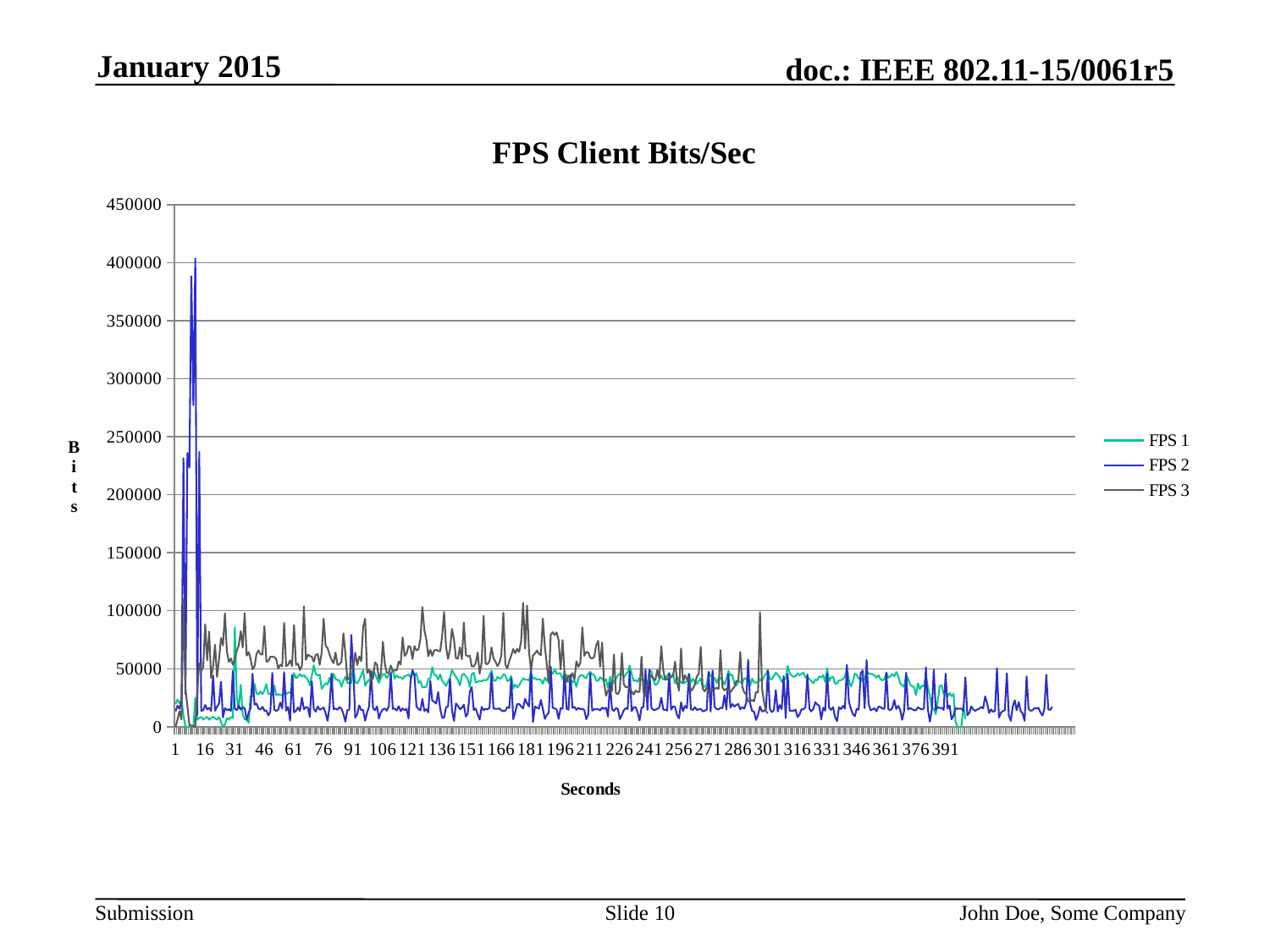
What is the title of the chart? FPS Client Bits/Sec How many series does the legend list? 3 Which series has the lowest peak value? FPS 1 Do the values of FPS 3 generally rise or fall from the start to the end of the x axis? fall What is the label of the x axis? Seconds What kind of chart is shown on the slide? line chart What is the highest value shown on the y axis? 450000 Is the highest value reached by FPS 2 greater or less than 350000? greater Is the highest value reached by FPS 1 greater or less than 150000? less Is the highest value reached by FPS 3 greater or less than 300000? less Between seconds 46 and 196, which series generally has the highest values? FPS 3